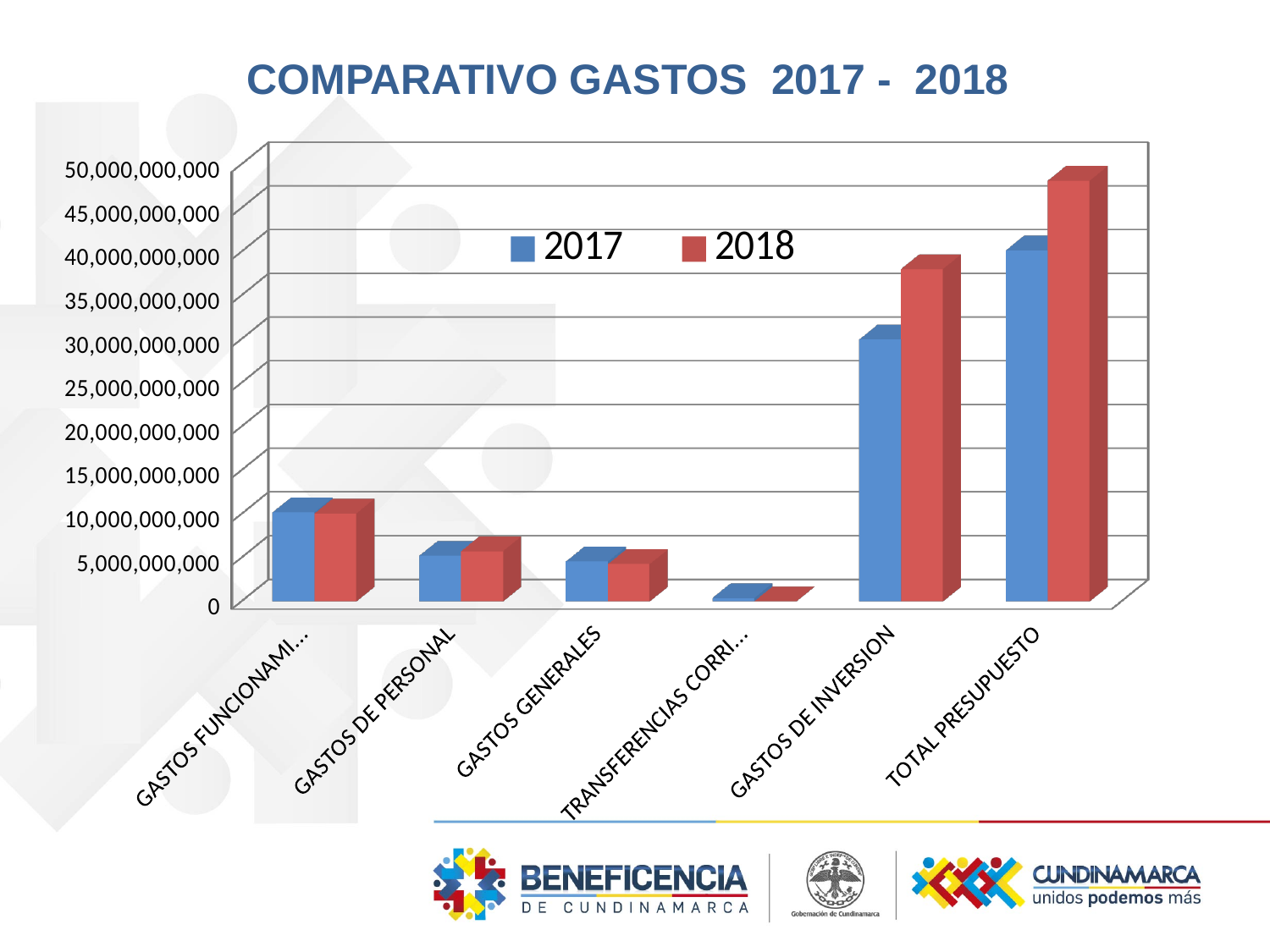
For GASTOS DE INVERSION, which year has the larger value, 2017 or 2018? 2018 What is the title of the chart? COMPARATIVO GASTOS 2017 - 2018 How many categories are shown on the x axis? 6 What kind of chart is shown on the slide? Bar chart For TOTAL PRESUPUESTO, which year has the larger value, 2017 or 2018? 2018 Is the 2018 value for GASTOS DE INVERSION greater or less than 35,000,000,000? greater Is the 2017 value for GASTOS DE INVERSION greater or less than 35,000,000,000? less Which category has the highest value for 2017? TOTAL PRESUPUESTO Is the 2017 value for GASTOS DE PERSONAL greater or less than 10,000,000,000? less Which category has the highest value for 2018? TOTAL PRESUPUESTO How many series does the legend list? 2